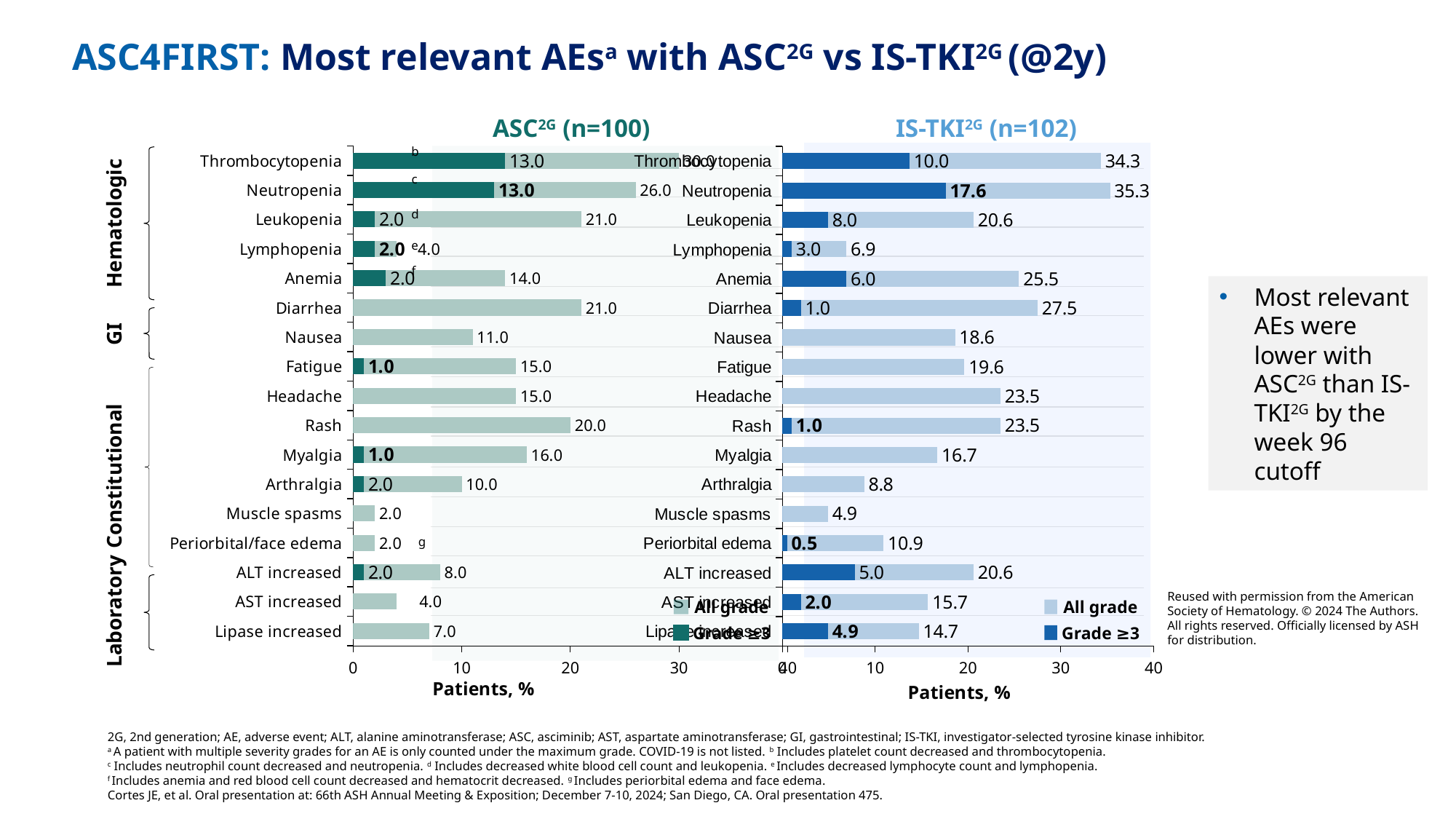
In the IS-TKI2G (n=102) chart, what is the Grade ≥3 value for Periorbital edema? 0.5 In the ASC2G (n=100) chart, what is the all-grade value for Diarrhea? 21.0 Which is larger: the all-grade value for Rash in the ASC2G (n=100) chart or in the IS-TKI2G (n=102) chart? IS-TKI2G (23.5) In the ASC2G (n=100) chart, what is the difference between the all-grade values for Neutropenia and Lymphopenia? 22.0 In the IS-TKI2G (n=102) chart, what is the all-grade value for Neutropenia? 35.3 In the IS-TKI2G (n=102) chart, which adverse event has the highest all-grade value? Neutropenia What type of chart is used for the ASC2G (n=100) data? Bar chart In the ASC2G (n=100) chart, what is the Grade ≥3 value for Neutropenia? 13.0 How many series does the legend of the IS-TKI2G (n=102) chart list? 2 In the IS-TKI2G (n=102) chart, what is the difference between the all-grade values for Headache and Myalgia? 6.8 How many adverse event categories are listed in the ASC2G (n=100) chart? 17